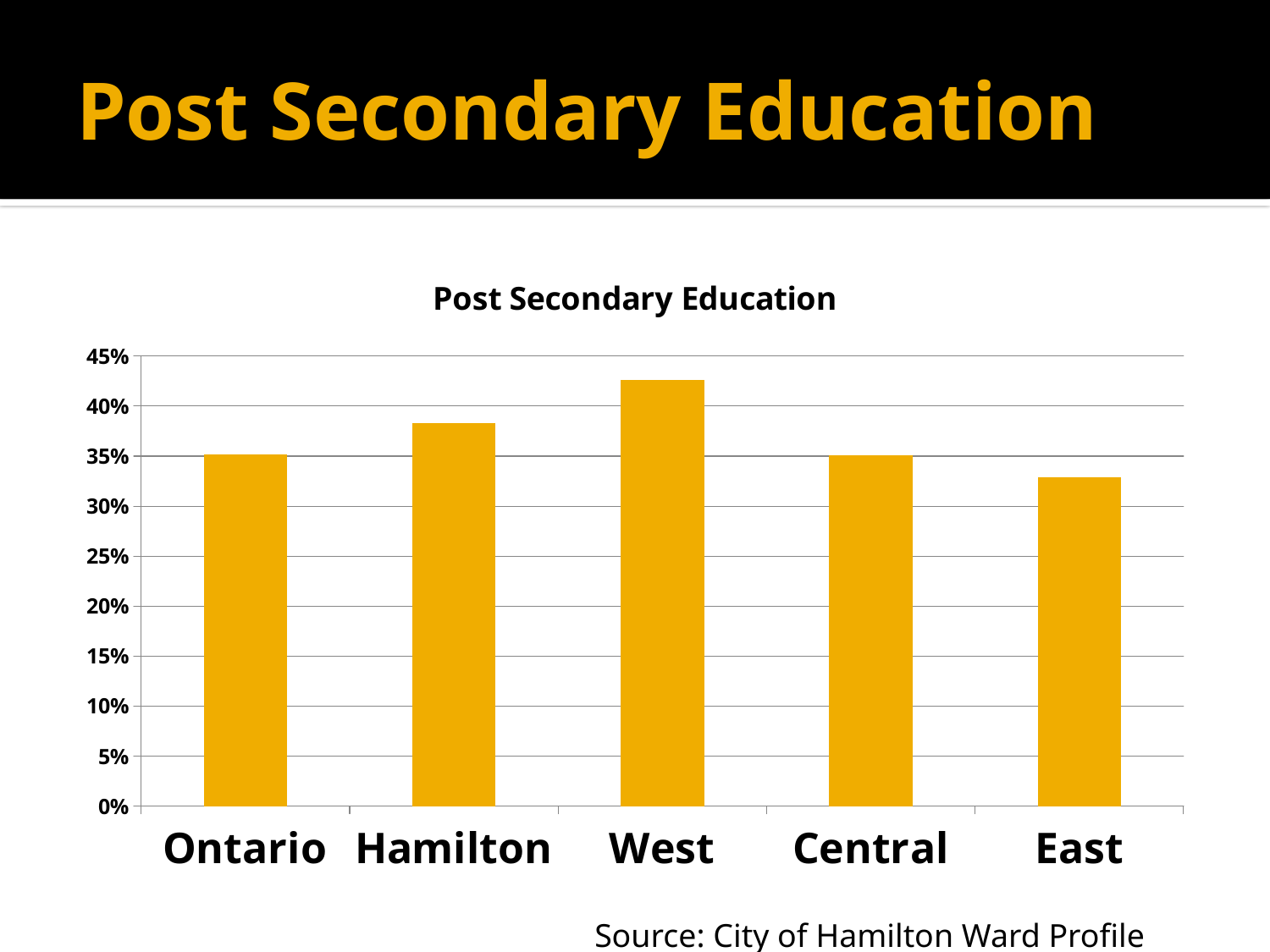
Is the value for Hamilton greater or less than 40%? less What source is cited below the chart? City of Hamilton Ward Profile Is the value for Hamilton greater or less than 35%? greater Which has the larger value, West or Ontario? West Is the value for West greater or less than 40%? greater What kind of chart is shown on the slide? bar chart Which category has the highest value in the chart? West Which category has the lowest value in the chart? East What is the title of the chart? Post Secondary Education Which has the larger value, Hamilton or East? Hamilton How many categories are shown on the x axis of the chart? 5